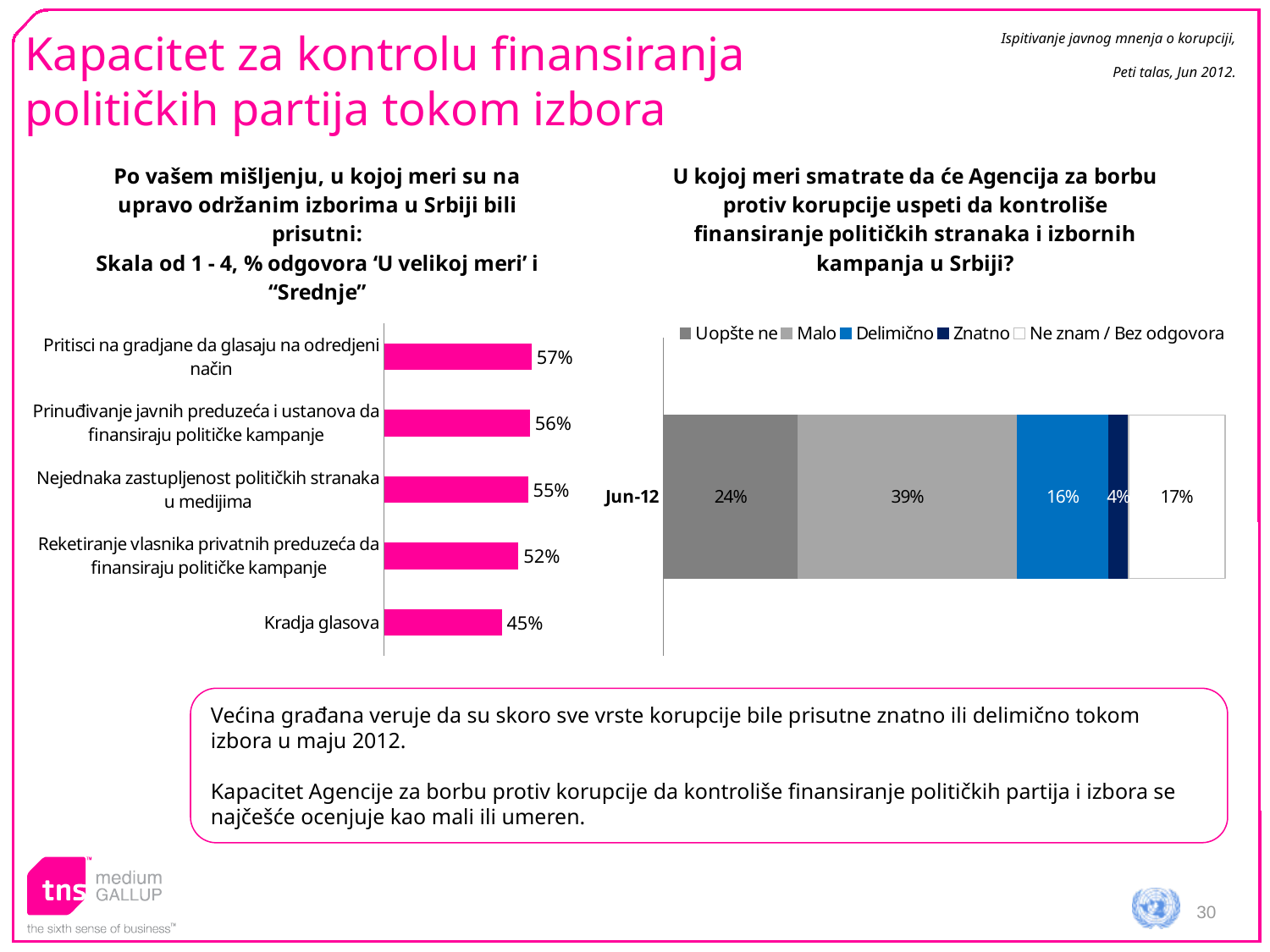
What kind of chart is the left chart? Bar chart In the right chart, what is the value for 'Znatno' in Jun-12? 4% In the left chart, what is the difference between 'Pritisci na gradjane da glasaju na odredjeni način' and 'Kradja glasova'? 12% In the left chart, which category has the highest value? Pritisci na gradjane da glasaju na odredjeni način In the left chart, which category has the lowest value? Kradja glasova In the left chart, what is the value for 'Pritisci na gradjane da glasaju na odredjeni način'? 57% In the right chart, what is the value for 'Malo' in Jun-12? 39% In the right chart, what is the total of the Jun-12 stacked bar? 100% In the right chart, how many series does the legend list? 5 In the left chart, what is the value for 'Kradja glasova'? 45% In the right chart, which is larger for Jun-12: 'Uopšte ne' or 'Delimično'? Uopšte ne In the left chart, how many categories are shown? 5